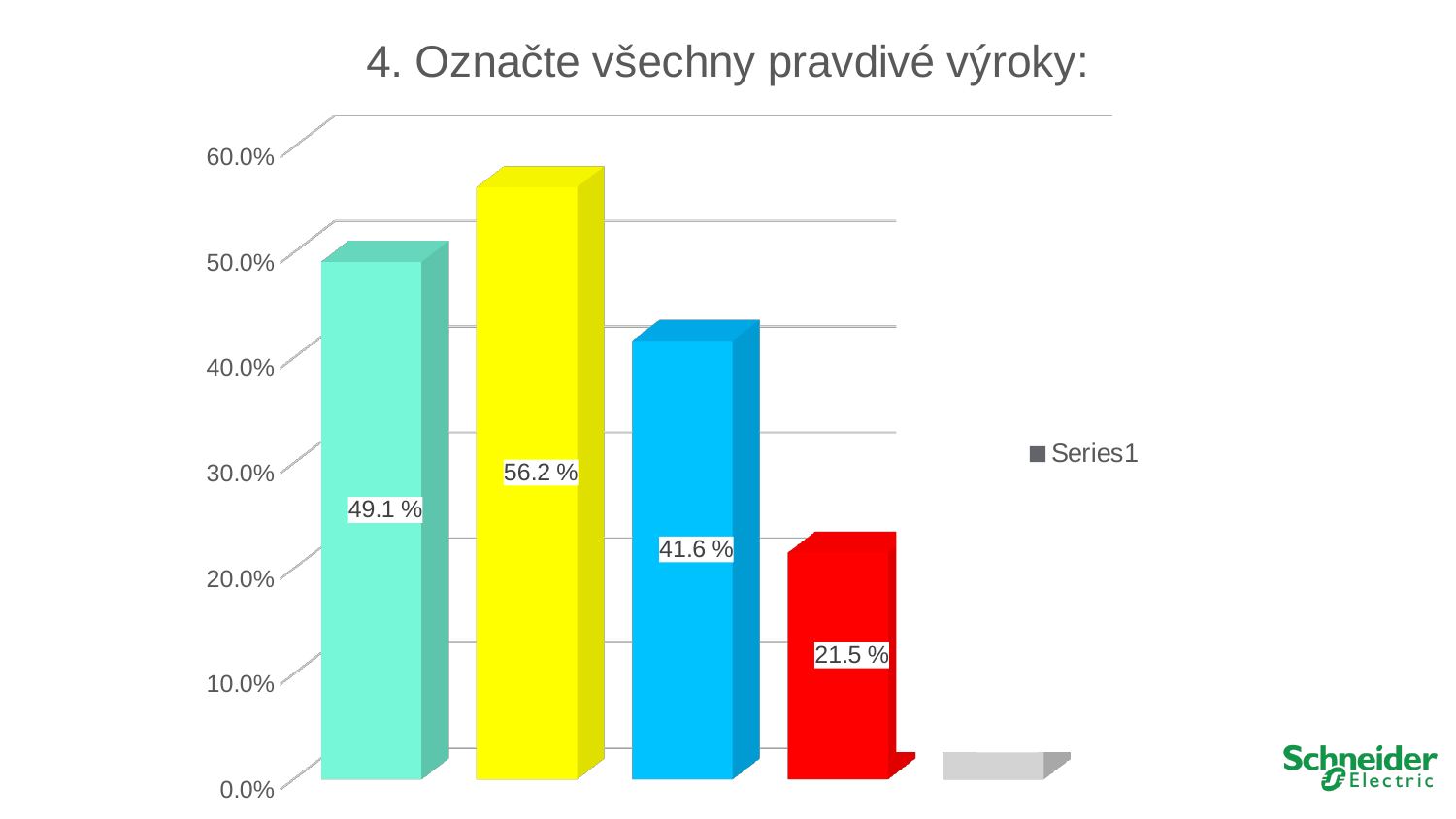
What is the value shown on the yellow bar? 56.2 % What is the value shown on the first (leftmost, light green) bar? 49.1 % How many series does the legend list? 1 What type of chart is shown on the slide? Bar chart Which bar has the highest value? The yellow bar (56.2 %) Which of the labelled bars has the lowest value? The red bar (21.5 %) Which is larger, the value of the light green bar or the value of the blue bar? The light green bar (49.1 %) What is the value shown on the red bar? 21.5 % How many bars on the chart have a data label? 4 Is the value of the blue bar greater or less than 50.0%? less What is the value shown on the blue bar? 41.6 % What is the difference between the yellow bar's value and the red bar's value? 34.7 %